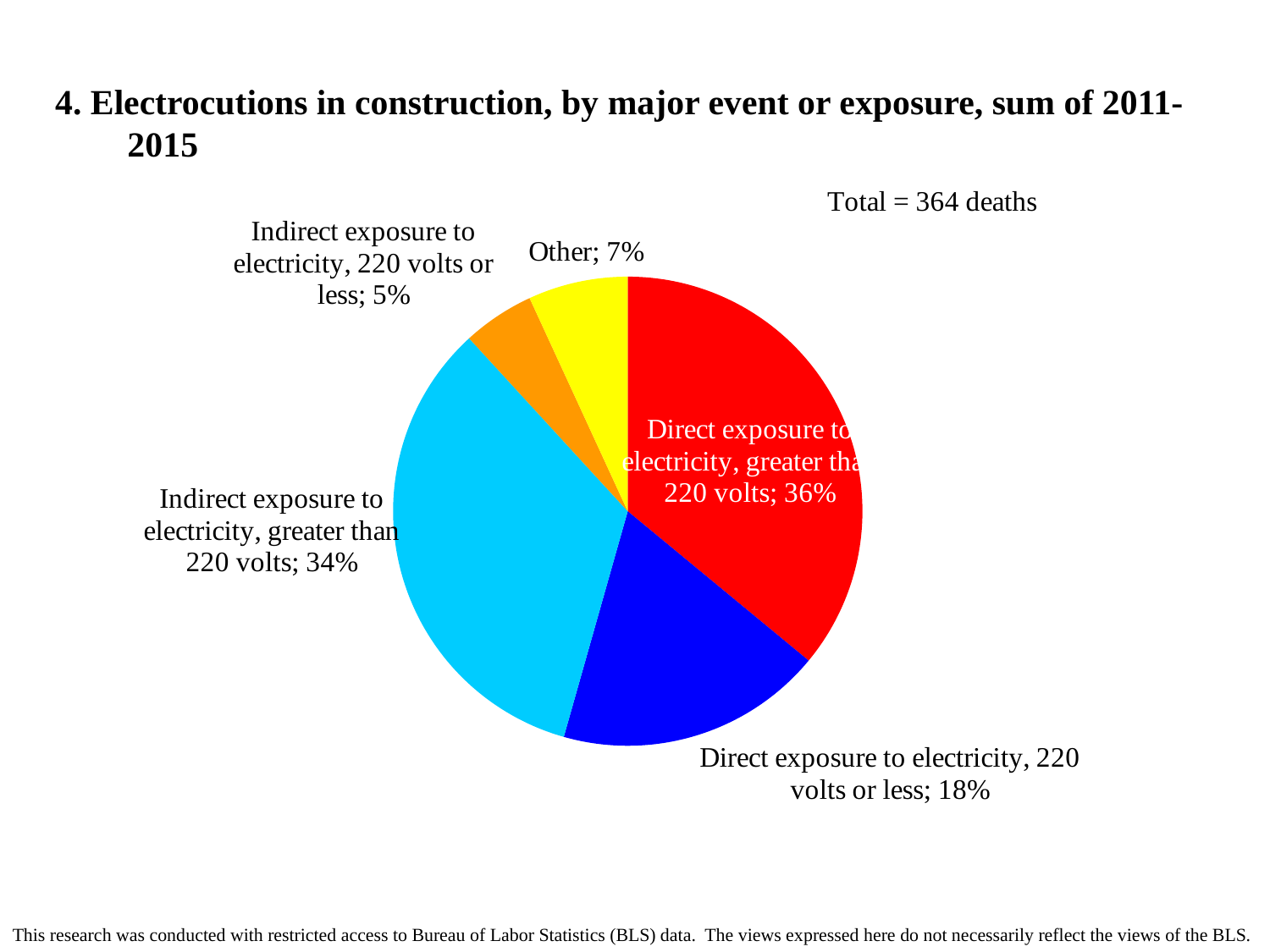
Which category accounts for the largest share of electrocutions? Direct exposure to electricity, greater than 220 volts What total number of deaths is stated on the slide? 364 deaths Which is larger: the share for Other or the share for indirect exposure to electricity, 220 volts or less? Other What share of electrocutions is attributed to indirect exposure to electricity, 220 volts or less? 5% What share of electrocutions is attributed to indirect exposure to electricity, greater than 220 volts? 34% What share of electrocutions is attributed to direct exposure to electricity, 220 volts or less? 18% Which category accounts for the smallest share of electrocutions? Indirect exposure to electricity, 220 volts or less How many categories does the pie chart show? 5 How many percentage points larger is the share for direct exposure to electricity, 220 volts or less than the share for Other? 11 What share of electrocutions is attributed to direct exposure to electricity, greater than 220 volts? 36% What kind of chart is shown on the slide? pie chart What share of electrocutions falls in the Other category? 7%